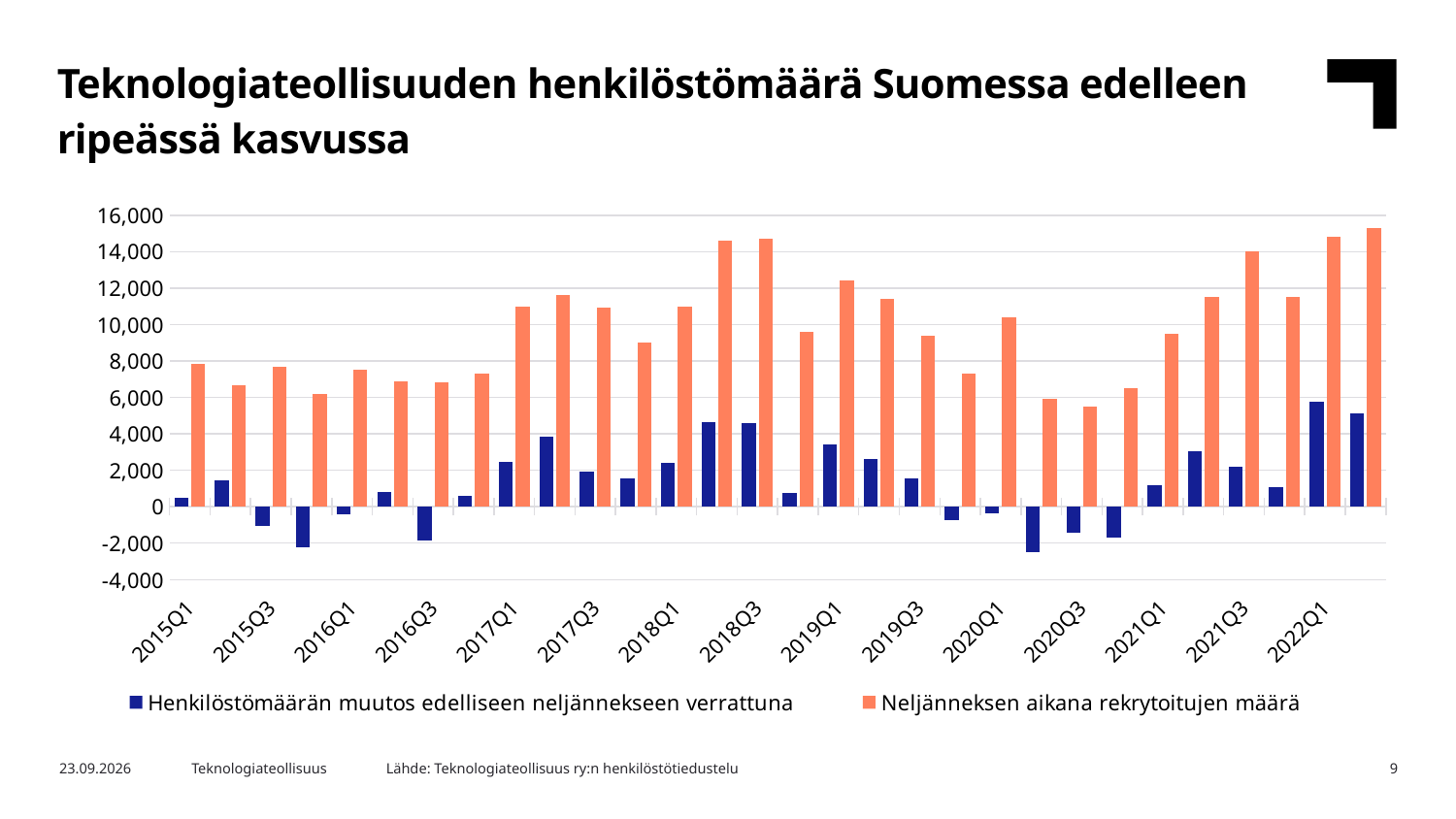
Is the value of 'Neljänneksen aikana rekrytoitujen määrä' for 2017Q1 greater or less than 10,000? greater Do the values of 'Neljänneksen aikana rekrytoitujen määrä' rise or fall from 2020Q3 to 2022Q1? rise What kind of chart is shown on the slide? bar chart Is the value of 'Henkilöstömäärän muutos edelliseen neljännekseen verrattuna' for 2020Q3 greater or less than 0? less Is the value of 'Neljänneksen aikana rekrytoitujen määrä' for 2020Q3 greater or less than 6,000? less Which quarter has the larger value of 'Neljänneksen aikana rekrytoitujen määrä', 2015Q1 or 2018Q3? 2018Q3 How many series does the legend list? 2 Which colour represents 'Neljänneksen aikana rekrytoitujen määrä' in the chart? orange How many quarters (bar pairs) are plotted on the x axis? 30 Which quarter has the larger value of 'Henkilöstömäärän muutos edelliseen neljännekseen verrattuna', 2017Q1 or 2022Q1? 2022Q1